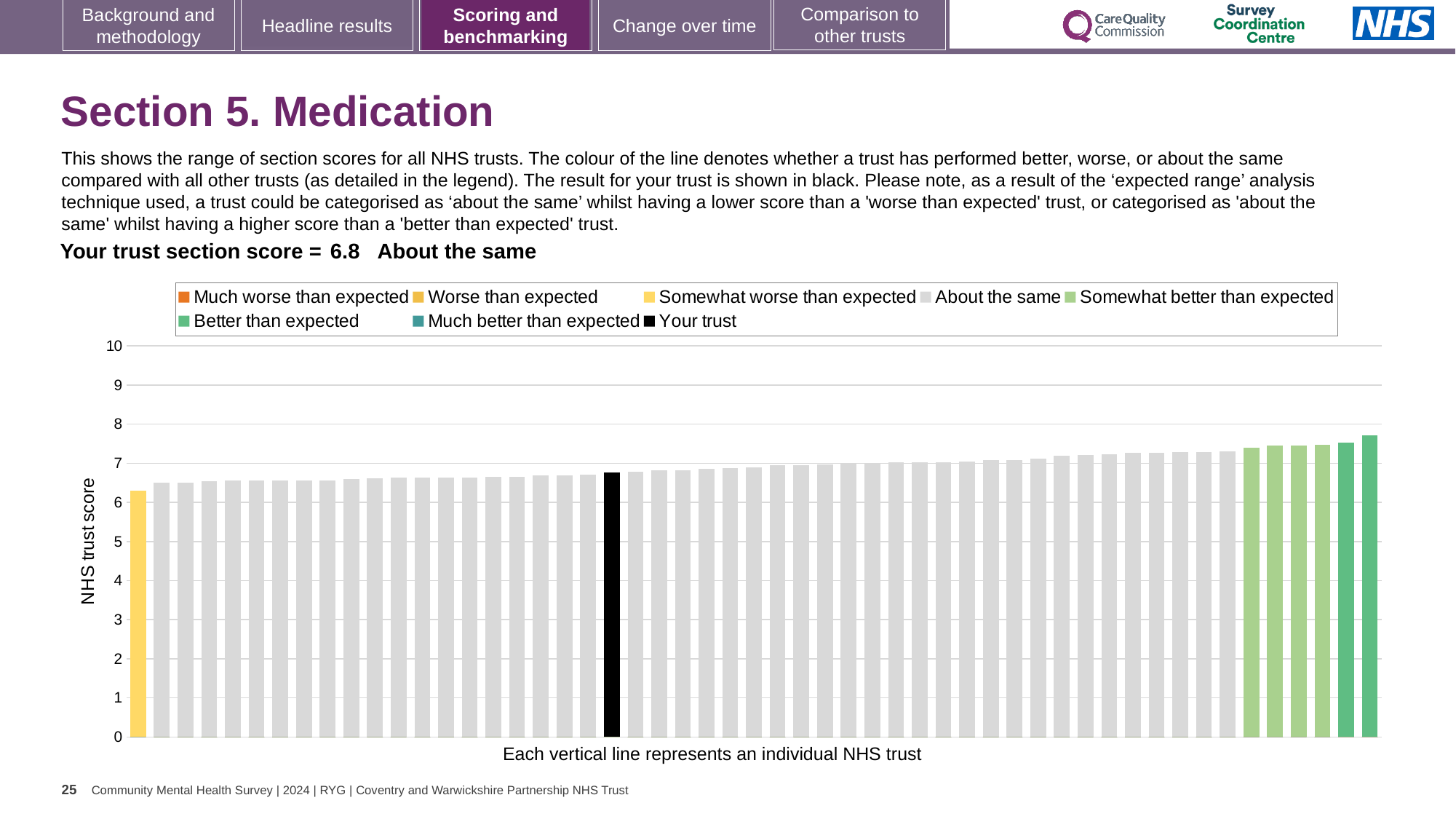
Do the bar values rise or fall from left to right along the x axis? rise What is the label on the vertical axis of the chart? NHS trust score Is the leftmost bar higher or lower than the black bar for your trust? lower What colour is the bar representing your trust? black Which performance category is your trust's section score placed in? About the same What kind of chart is shown on the slide? bar chart Is the value of the tallest bar on the chart greater or less than 7? greater Is the value of the black bar (your trust) greater or less than 6? greater Is the value of the leftmost (yellow) bar greater or less than 7? less What is the section score for your trust shown on the slide? 6.8 Which legend category does the tallest bar on the chart belong to? Better than expected How many entries does the chart legend list? 8